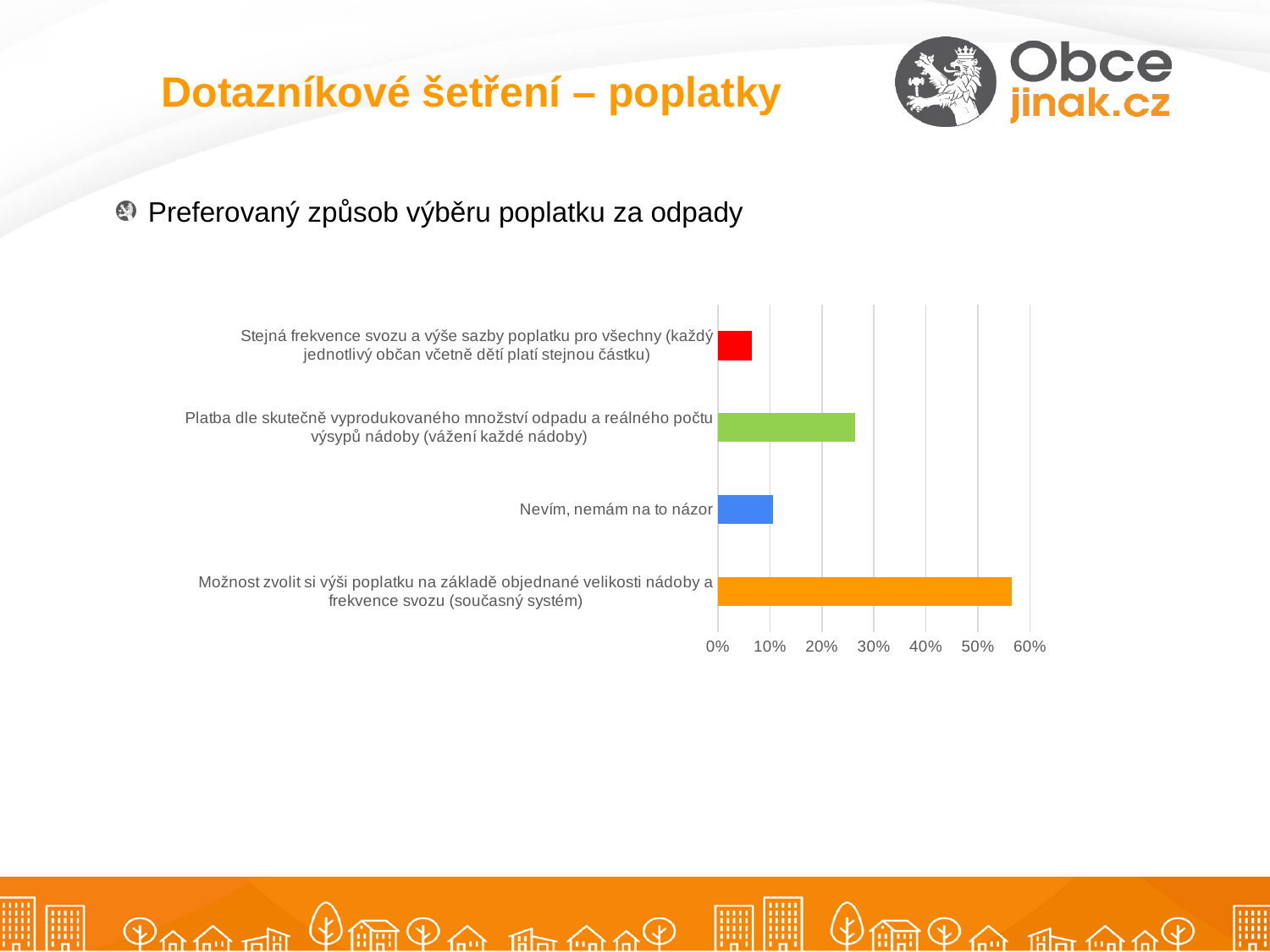
Which category has the highest value? Možnost zvolit si výši poplatku na základě objednané velikosti nádoby a frekvence svozu (současný systém) How many categories (bars) does the chart show? 4 Which category has the lowest value? Stejná frekvence svozu a výše sazby poplatku pro všechny (každý jednotlivý občan včetně dětí platí stejnou částku) Is the value for 'Platba dle skutečně vyprodukovaného množství odpadu a reálného počtu výsypů nádoby (vážení každé nádoby)' greater or less than 30%? less Is the value for 'Platba dle skutečně vyprodukovaného množství odpadu a reálného počtu výsypů nádoby (vážení každé nádoby)' greater or less than 20%? greater Which is larger: the value for 'Platba dle skutečně vyprodukovaného množství odpadu...' or the value for 'Nevím, nemám na to názor'? Platba dle skutečně vyprodukovaného množství odpadu a reálného počtu výsypů nádoby (vážení každé nádoby) What colour is the bar for 'Nevím, nemám na to názor'? blue Is the value for 'Možnost zvolit si výši poplatku na základě objednané velikosti nádoby a frekvence svozu (současný systém)' greater or less than 50%? greater What kind of chart is shown on the slide? bar chart What is the highest value shown on the horizontal axis of the chart? 60%